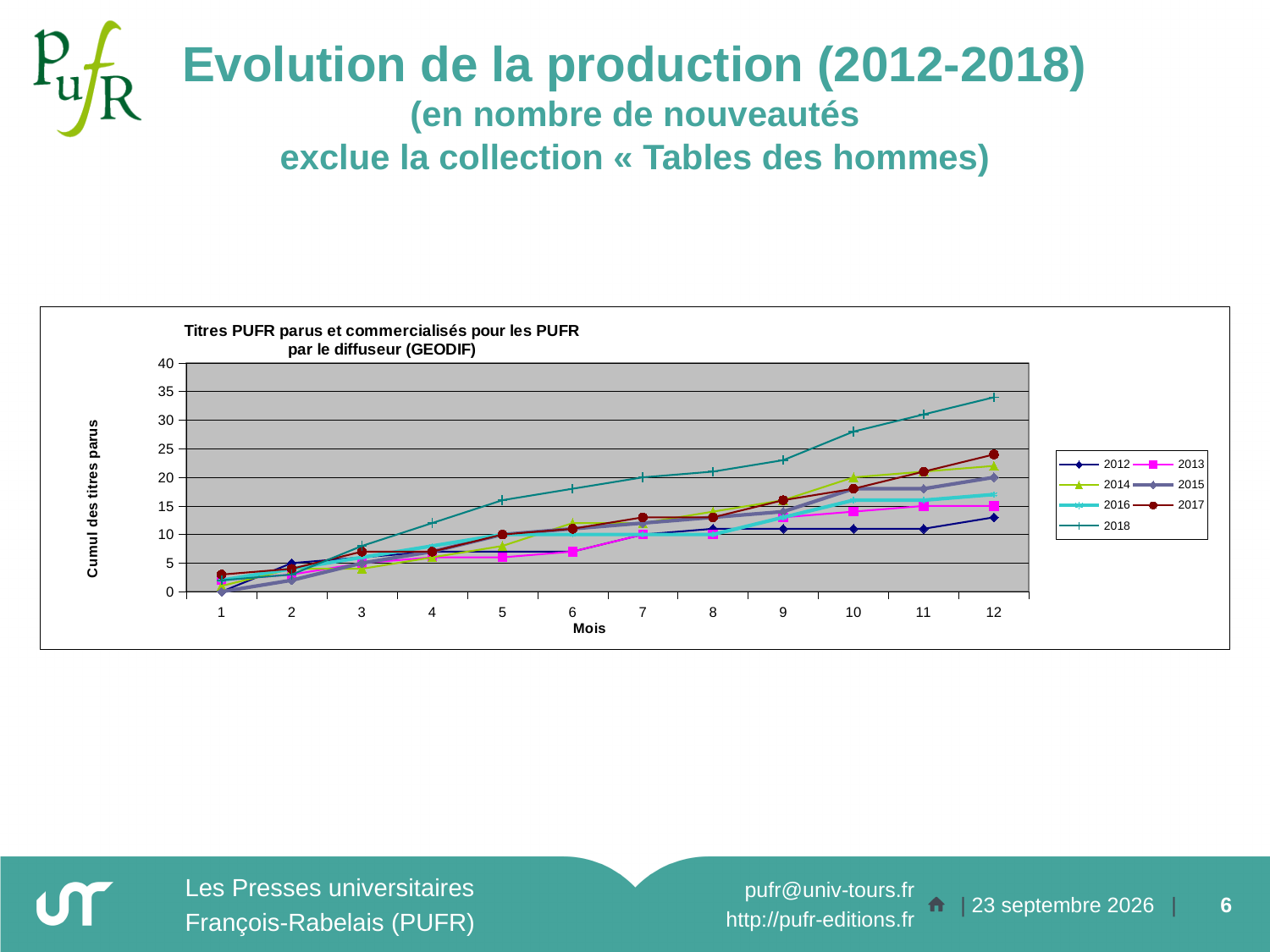
Is the value for 2017 at month 12 greater or less than 20? greater What kind of chart is shown on the slide? Line chart Is the value for 2012 at month 12 greater or less than 15? less Which series has the lowest value at month 12? 2012 At month 12, which is larger: the value for 2018 or the value for 2012? 2018 What is the label of the y axis of the chart? Cumul des titres parus Which series has the highest value at month 12? 2018 Does the 2018 series rise or fall from month 1 to month 12? Rise At month 10, which is larger: the value for 2018 or the value for 2017? 2018 How many months are plotted along the x axis of the chart? 12 How many series does the chart legend list? 7 Is the value for 2018 at month 10 greater or less than 25? greater